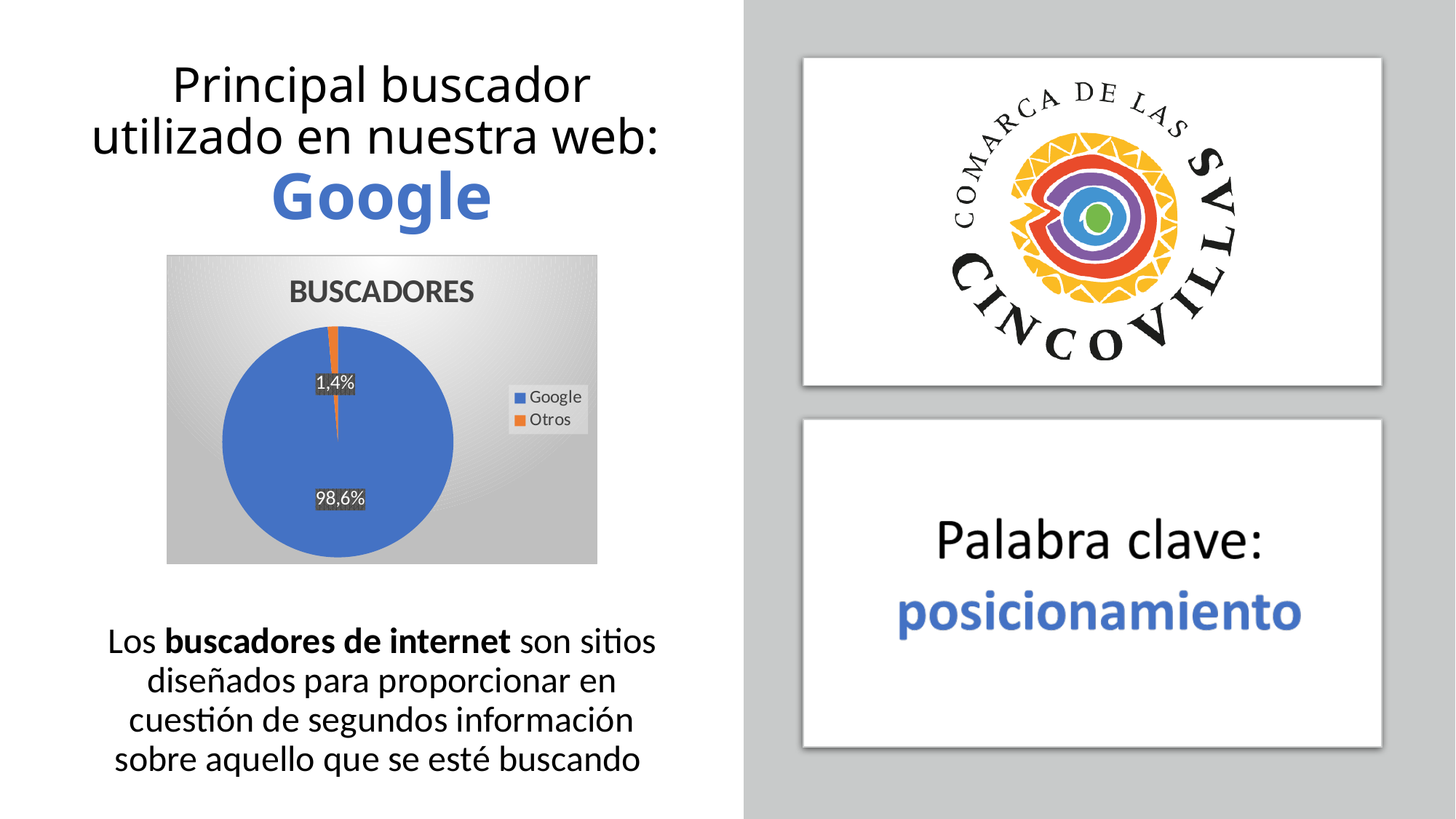
How many categories does the legend of the pie chart list? 2 What is the title of the chart? BUSCADORES What kind of chart is shown under the title BUSCADORES? pie chart What colour is the Otros slice in the pie chart? orange What share of the pie does Google have? 98,6% Which category has the largest slice of the pie? Google What is the difference in percentage points between the Google slice and the Otros slice? 97,2 Which category has the smallest slice of the pie? Otros What share of the pie does Otros have? 1,4% How many slices does the pie chart have? 2 Which is larger, the Google slice or the Otros slice? Google